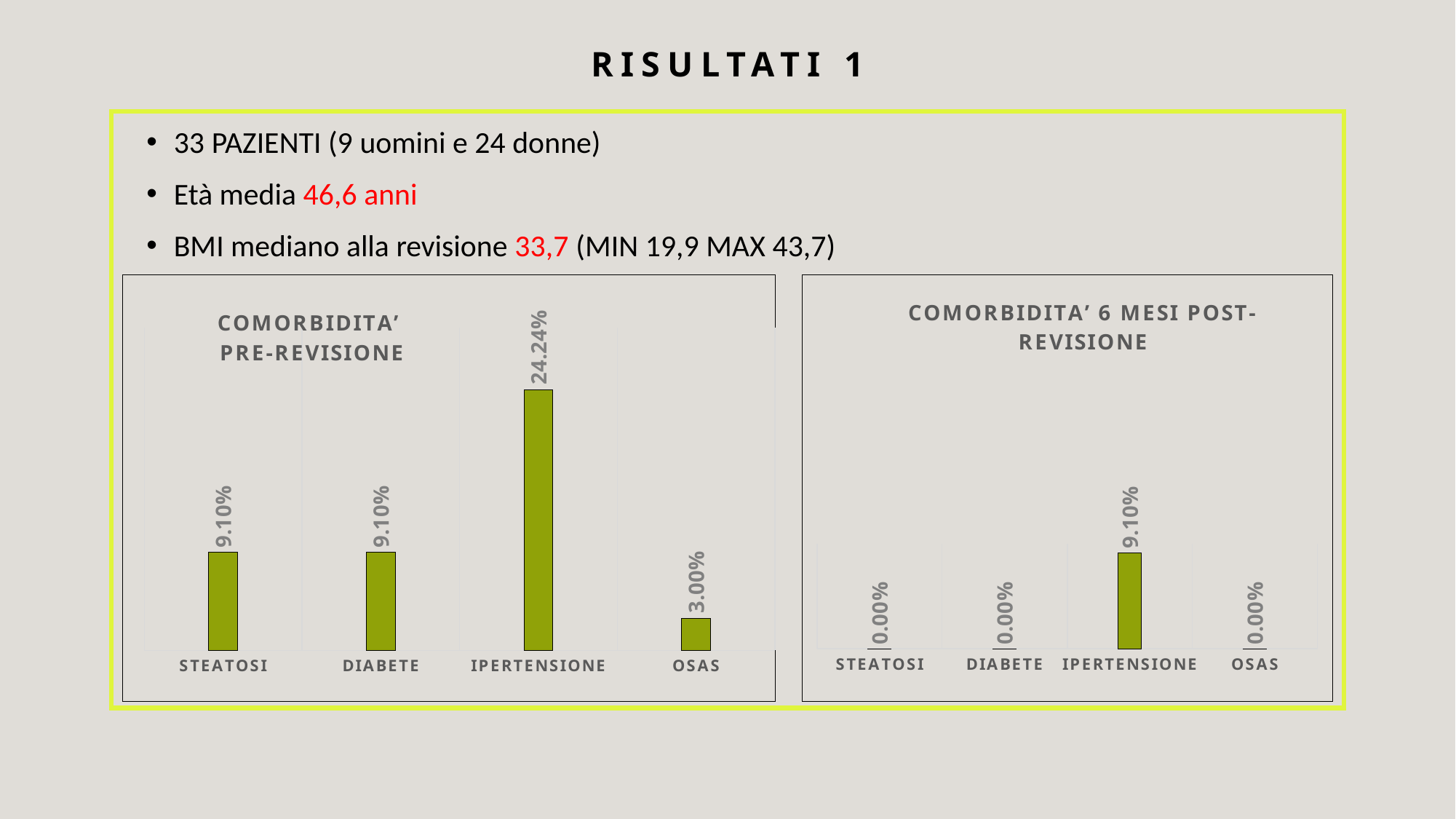
What is the difference between the IPERTENSIONE value in the 'COMORBIDITA' PRE-REVISIONE' chart and the IPERTENSIONE value in the 'COMORBIDITA' 6 MESI POST-REVISIONE' chart? 15.14% In the 'COMORBIDITA' PRE-REVISIONE' chart, which category has the highest value? IPERTENSIONE In the 'COMORBIDITA' PRE-REVISIONE' chart, what is the difference between the values for IPERTENSIONE and DIABETE? 15.14% In the 'COMORBIDITA' PRE-REVISIONE' chart, which is larger, the value for STEATOSI or the value for OSAS? STEATOSI In the 'COMORBIDITA' PRE-REVISIONE' chart, what is the value for IPERTENSIONE? 24.24% In the 'COMORBIDITA' 6 MESI POST-REVISIONE' chart, what is the value for IPERTENSIONE? 9.10% In the 'COMORBIDITA' 6 MESI POST-REVISIONE' chart, which category has the highest value? IPERTENSIONE How many categories are shown in the 'COMORBIDITA' 6 MESI POST-REVISIONE' chart? 4 In the 'COMORBIDITA' 6 MESI POST-REVISIONE' chart, what is the value for DIABETE? 0.00% In the 'COMORBIDITA' PRE-REVISIONE' chart, which category has the lowest value? OSAS In the 'COMORBIDITA' PRE-REVISIONE' chart, what is the value for OSAS? 3.00% What kind of chart is the 'COMORBIDITA' PRE-REVISIONE' chart? Bar chart